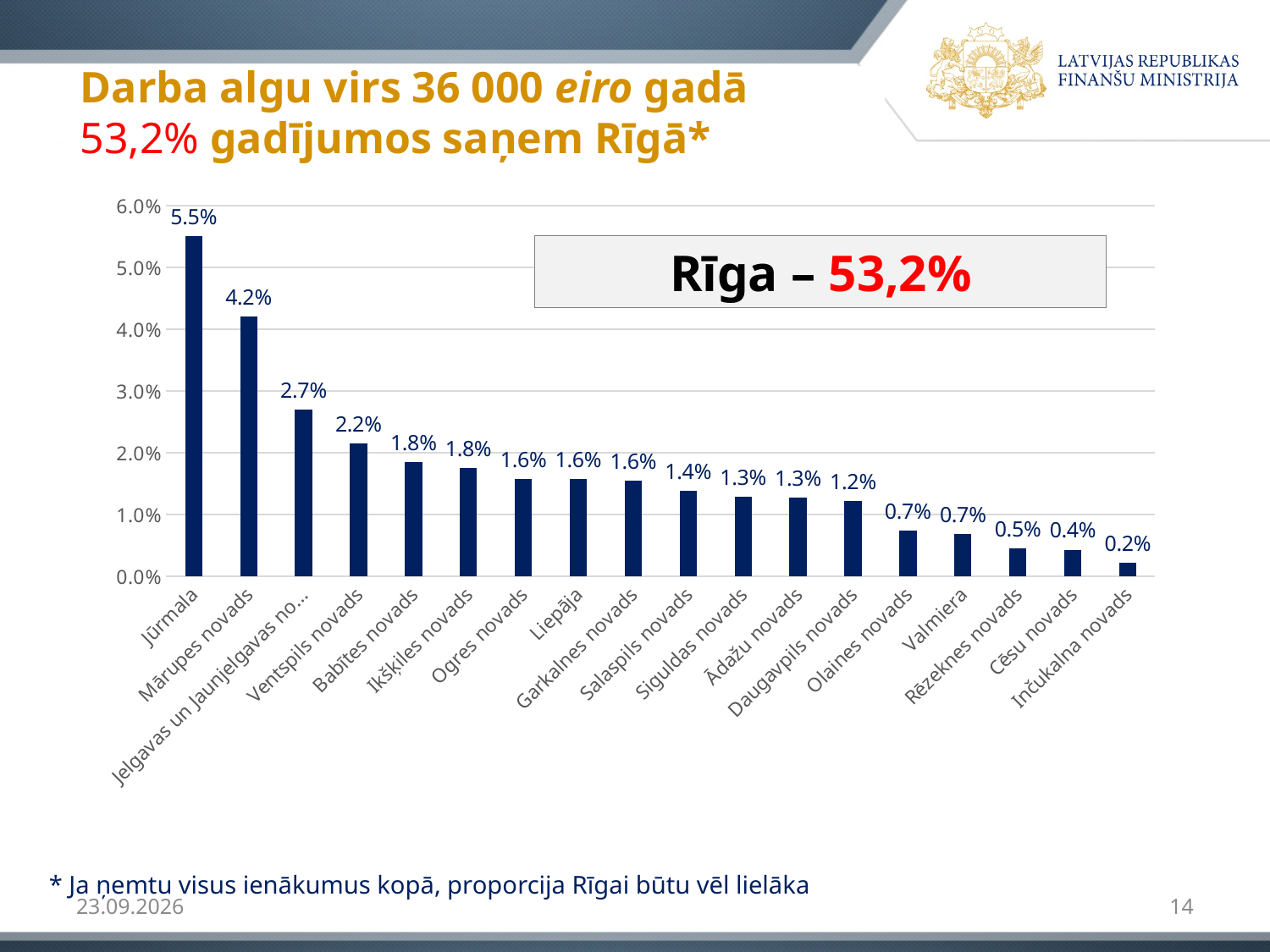
Which category has the lowest value? Inčukalna novads What share is given for Rīga in the box on the chart? 53,2% What is the difference between the values for Jūrmala and Mārupes novads? 1.3% What is the value for Daugavpils novads? 1.2% What kind of chart is shown on the slide? bar chart Is the value for Ventspils novads greater or less than 2.0%? greater Which category has the highest value among the bars? Jūrmala What is the value for Jūrmala? 5.5% What is the value for Ventspils novads? 2.2% What is the value for Mārupes novads? 4.2% How many categories are shown as bars in the chart? 18 Which is larger, the value for Salaspils novads or the value for Olaines novads? Salaspils novads